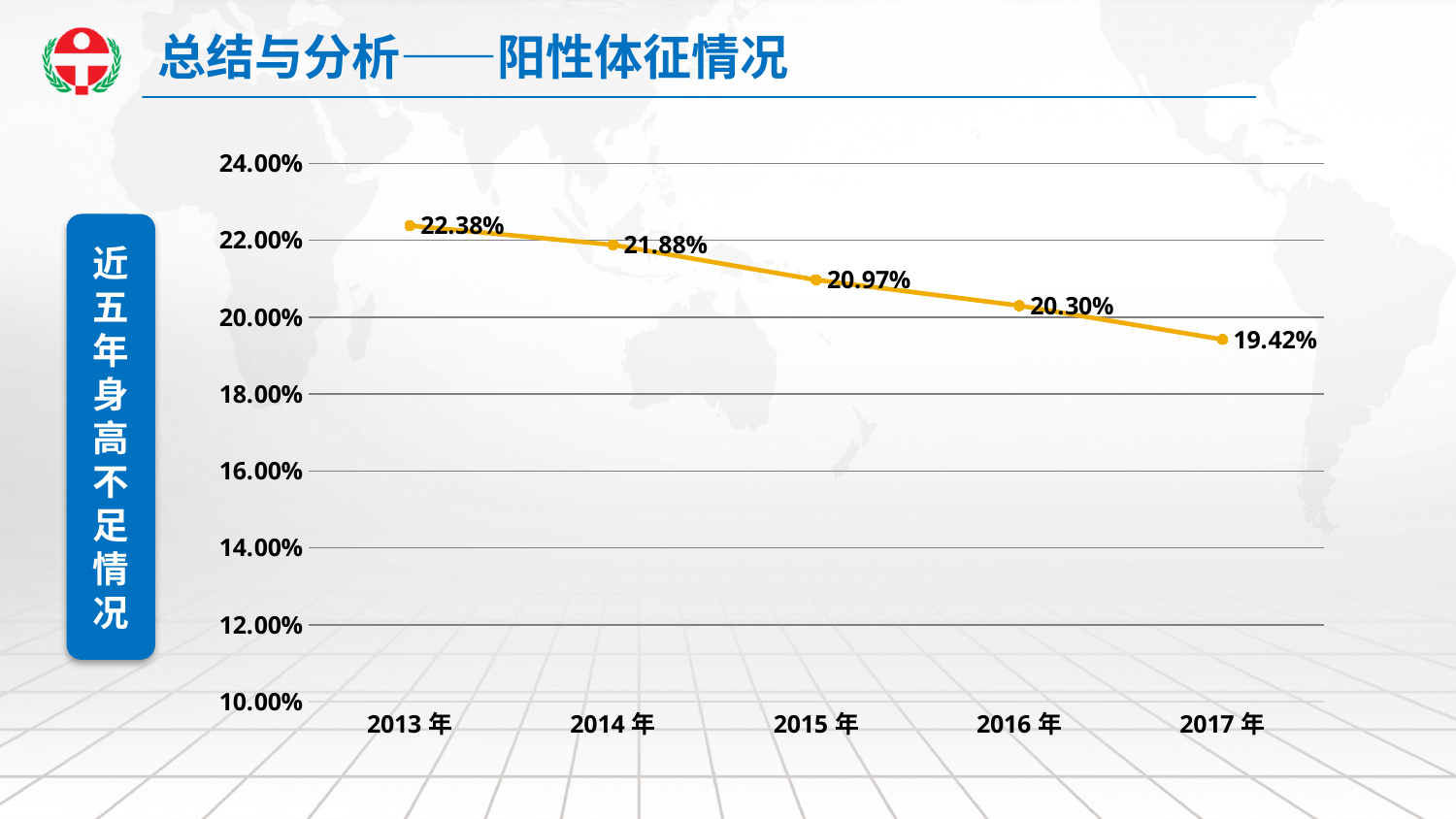
Which is larger, the value for 2014年 or the value for 2016年? 2014年 What kind of chart is shown on the slide? line chart Which year has the highest value? 2013年 What is the value for 2015年? 20.97% What is the value for 2013年? 22.38% Is the value for 2017年 greater or less than 20.00%? less Do the values rise or fall from 2013年 to 2017年? fall What is the value for 2017年? 19.42% What is the difference between the values for 2014年 and 2016年? 1.58% How many years are plotted on the chart? 5 What is the difference between the values for 2013年 and 2017年? 2.96% Which year has the lowest value? 2017年